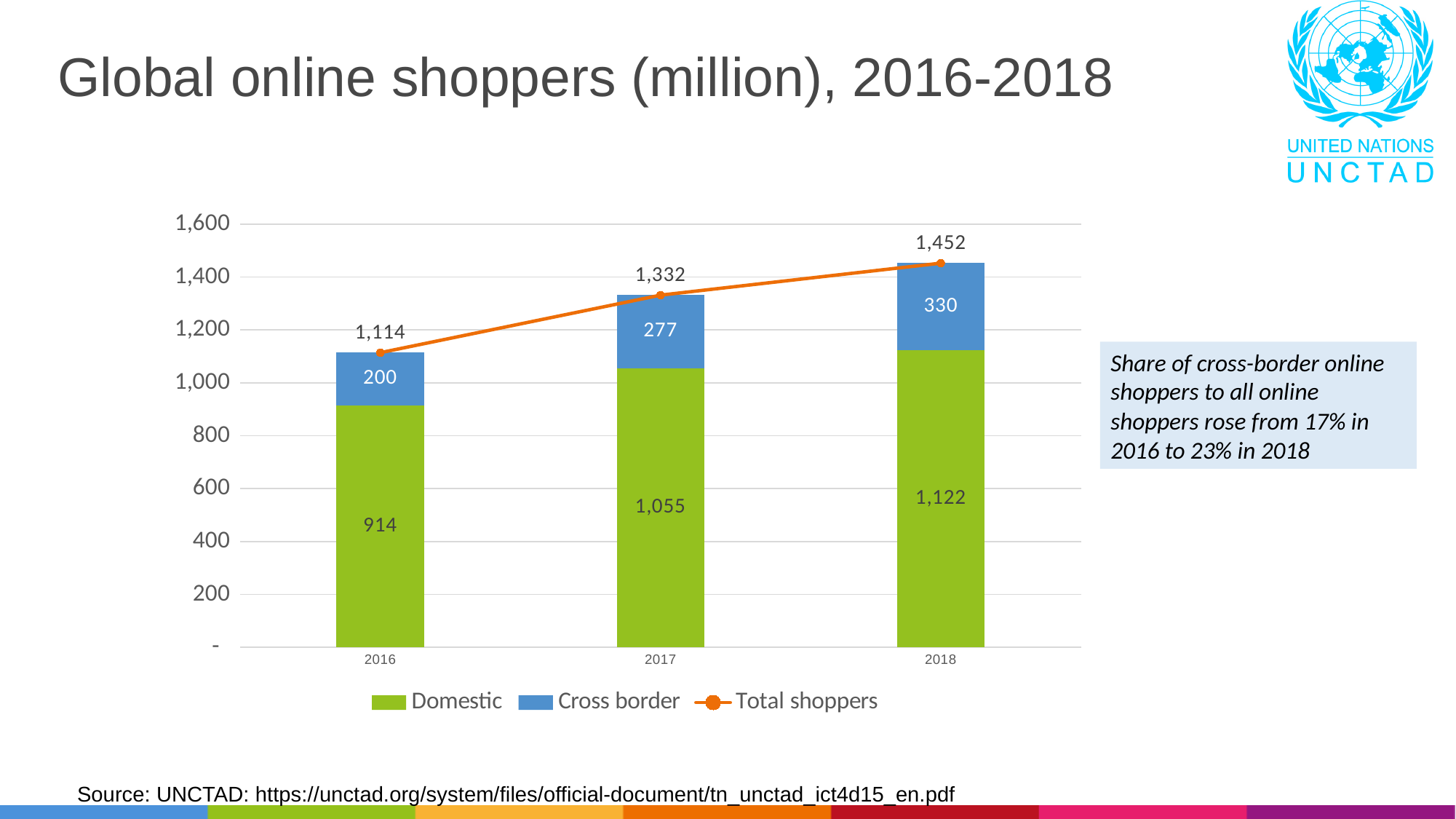
What is the Total shoppers value for 2018? 1,452 Which year has the highest Cross border value? 2018 What is the total of the stacked bar for 2017? 1,332 How many series does the legend list? 3 Which year has the lowest Domestic value? 2016 How many years are shown on the x axis? 3 What is the Domestic value for 2017? 1,055 Which is larger, the Cross border value for 2017 or for 2018? 2018 Do the Total shoppers values rise or fall from 2016 to 2018? rise What is the difference between the Total shoppers values for 2018 and 2016? 338 What is the Cross border value for 2016? 200 Is the Domestic value for 2016 greater or less than 1,000? less